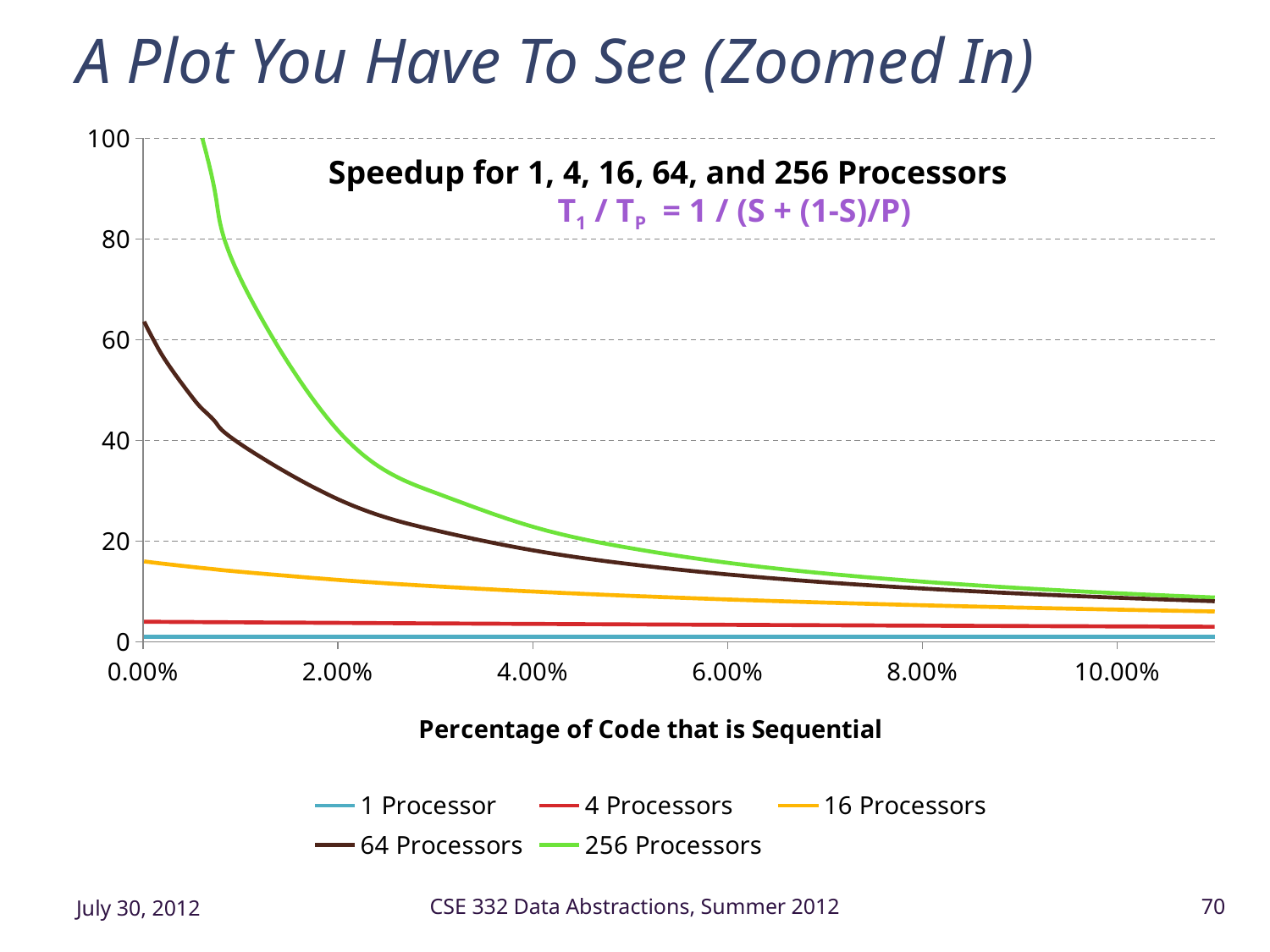
Which series has the highest value at 2.00%? 256 Processors What is the label of the x axis? Percentage of Code that is Sequential Is the value for 16 Processors at 0.00% greater or less than 20? less At 10.00%, which is larger: the value for 16 Processors or the value for 4 Processors? 16 Processors How many series does the legend list? 5 Which series has the lowest value across the whole x axis? 1 Processor What is the title of the chart? Speedup for 1, 4, 16, 64, and 256 Processors Is the value for 256 Processors at 6.00% greater or less than 20? less Is the value for 256 Processors at 2.00% greater or less than 40? greater At 2.00%, which is larger: the value for 256 Processors or the value for 64 Processors? 256 Processors Does the 256 Processors line rise or fall as the percentage of sequential code increases? fall What kind of chart is shown on the slide? line chart